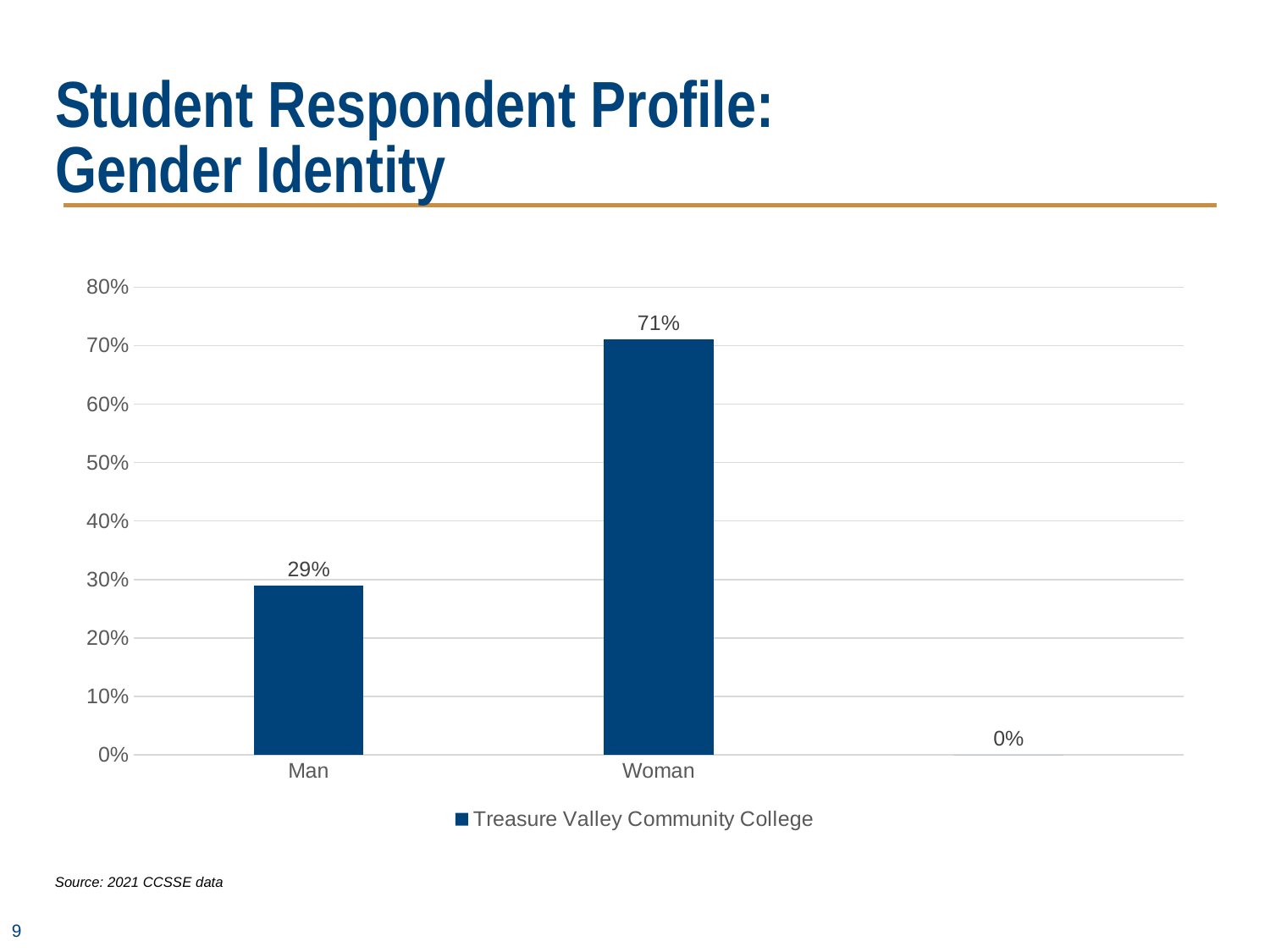
Is the value for Woman greater or less than 60%? greater How many series does the legend list? 1 What is the title of the slide? Student Respondent Profile: Gender Identity Which category has the highest value? Woman Is the value for Man greater or less than 30%? less What is the difference between the values for Woman and Man? 42% What is the value for Man? 29% What is the value for Woman? 71% What kind of chart is shown on the slide? bar chart What is the combined value of Man and Woman? 100% Which of Man or Woman has the larger value? Woman What series name is shown in the legend? Treasure Valley Community College